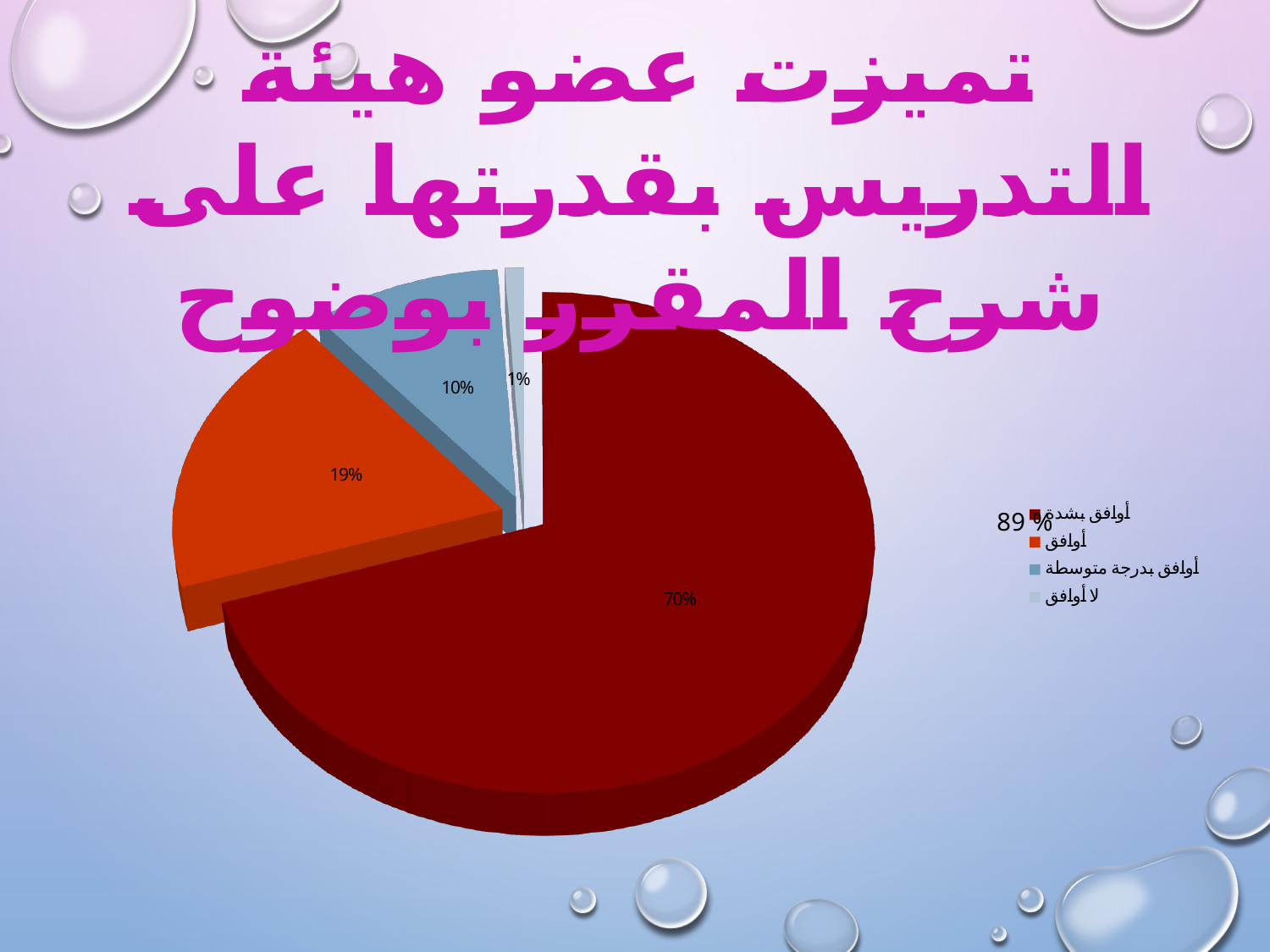
Which category has the smallest slice of the pie? لا أوافق Which slice is larger, أوافق or أوافق بدرجة متوسطة? أوافق What kind of chart is shown on the slide? pie chart How many slices does the pie chart have? 4 What percentage is shown for the slice labelled لا أوافق? 1% What percentage is shown for the slice labelled أوافق? 19% How many entries does the legend of the pie chart list? 4 Which category has the largest slice of the pie? أوافق بشدة What percentage is shown for the slice labelled أوافق بدرجة متوسطة? 10% What colour is the slice for أوافق بشدة? dark red What is the difference in percentage points between the أوافق بشدة slice and the أوافق slice? 51 What percentage is shown for the slice labelled أوافق بشدة? 70%